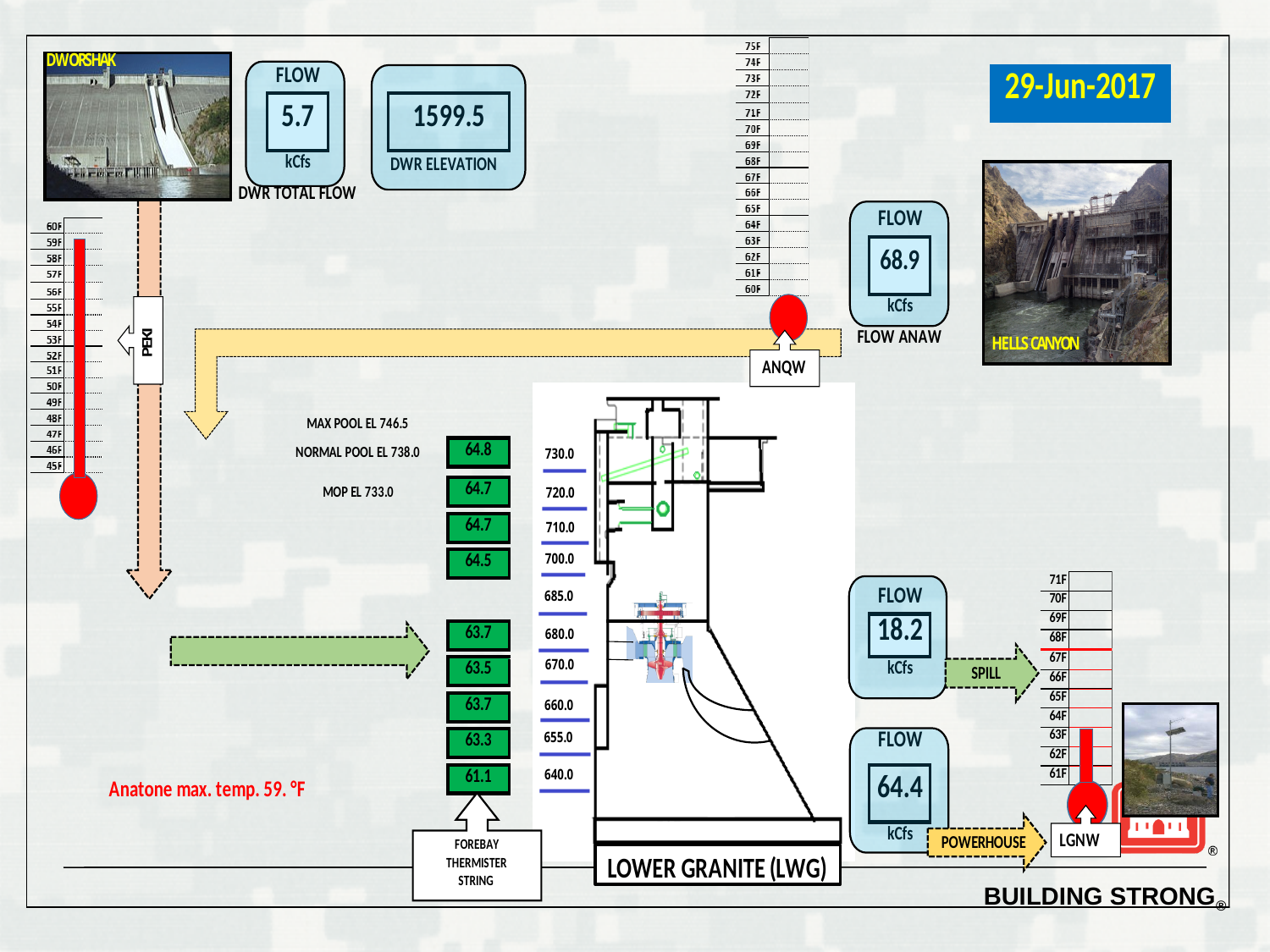
Which is larger at Lower Granite, the SPILL flow or the POWERHOUSE flow? POWERHOUSE On the Lower Granite (LWG) forebay thermistor string, what temperature is shown at elevation 730.0? 64.8 Do the forebay thermistor string temperatures rise or fall going from elevation 730.0 down to 640.0? fall On the forebay thermistor string, what temperature is shown at elevation 640.0? 61.1 On the forebay thermistor string, what temperature is shown at elevation 700.0? 64.5 Which elevation on the forebay thermistor string has the highest temperature reading? 730.0 What is the DWR elevation shown on the slide? 1599.5 What is the difference between the highest (64.8) and lowest (61.1) readings on the forebay thermistor string? 3.7 What is the total of the SPILL flow (18.2 kCfs) and the POWERHOUSE flow (64.4 kCfs) at Lower Granite? 82.6 kCfs How many temperature readings are shown on the forebay thermistor string? 9 What is the DWR total flow shown in the FLOW box next to the Dworshak picture? 5.7 kCfs Which elevation on the forebay thermistor string has the lowest temperature reading? 640.0